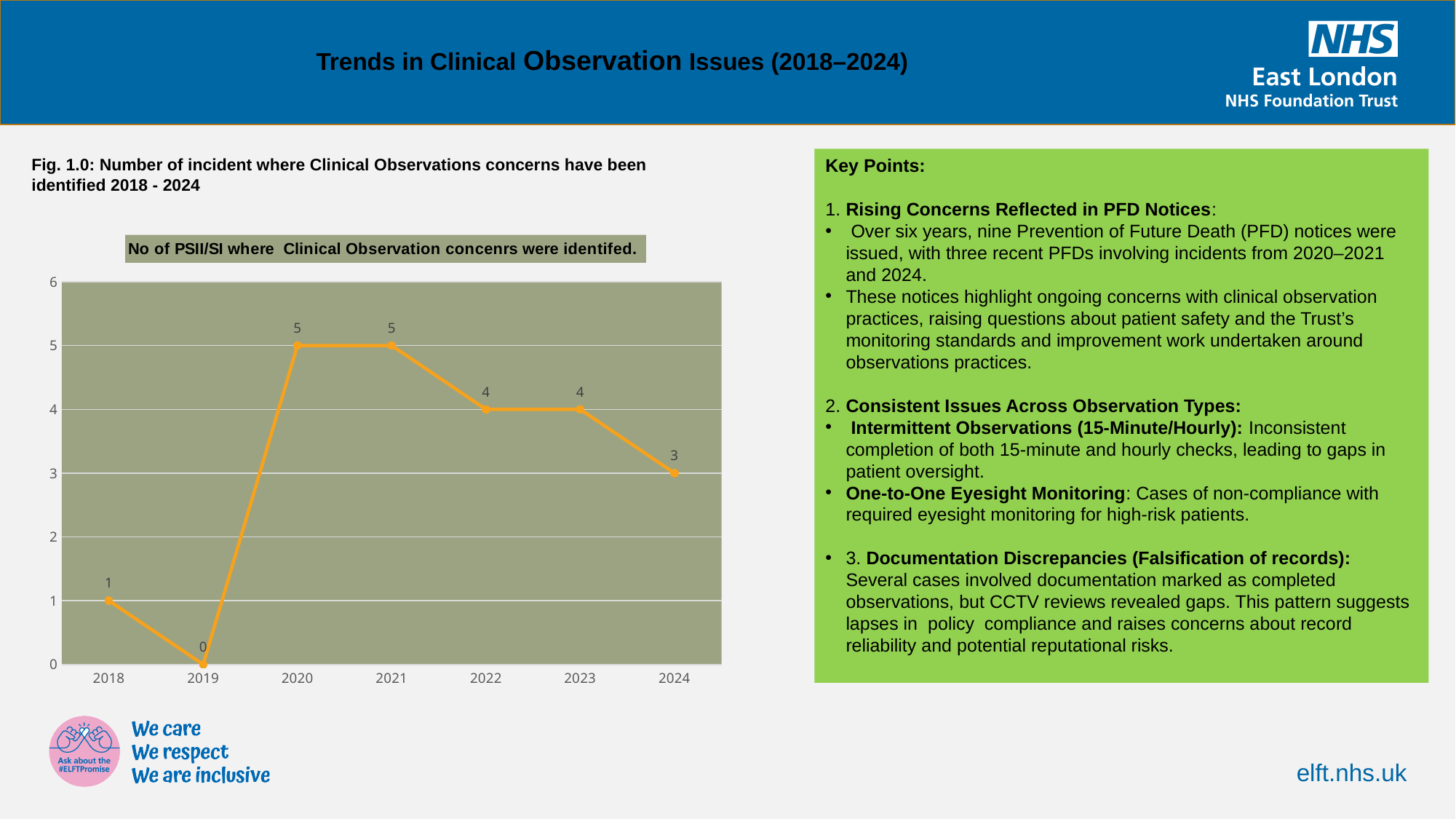
What is the difference between the values for 2021 and 2024? 2 Which is larger, the value for 2018 or the value for 2022? 2022 What is the value for 2019? 0 What is the difference between the values for 2020 and 2018? 4 Which year has the lowest value? 2019 What is the title of the chart? No of PSII/SI where Clinical Observation concenrs were identifed. Do the values rise or fall from 2021 to 2024? fall What is the value for 2024? 3 What colour is the line on the chart? orange What is the value for 2020? 5 What kind of chart is shown? line chart How many years are plotted on the chart? 7